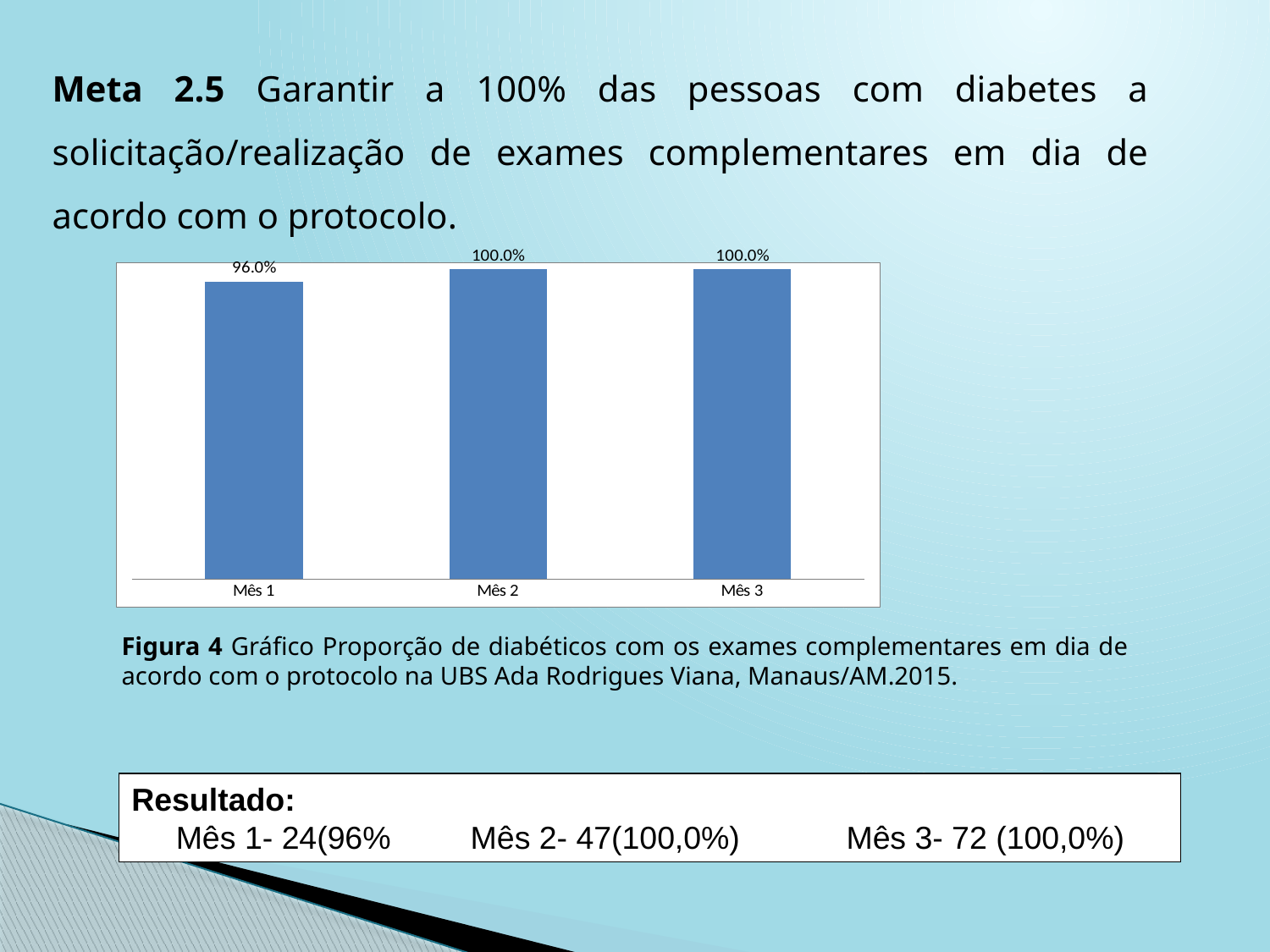
Do the values change between Mês 2 and Mês 3? No, both are 100.0% What is the value for Mês 1? 96.0% What is the value for Mês 3? 100.0% What is the difference between the values for Mês 2 and Mês 1? 4.0% Which category has the lowest value? Mês 1 What figure number is given in the caption below the chart? Figura 4 What is the value for Mês 2? 100.0% What kind of chart is shown on the slide? Bar chart How many categories are shown on the x axis? 3 Which is larger, the value for Mês 1 or the value for Mês 3? Mês 3 Do the values rise or fall from Mês 1 to Mês 2? Rise What colour are the bars in the chart? Blue